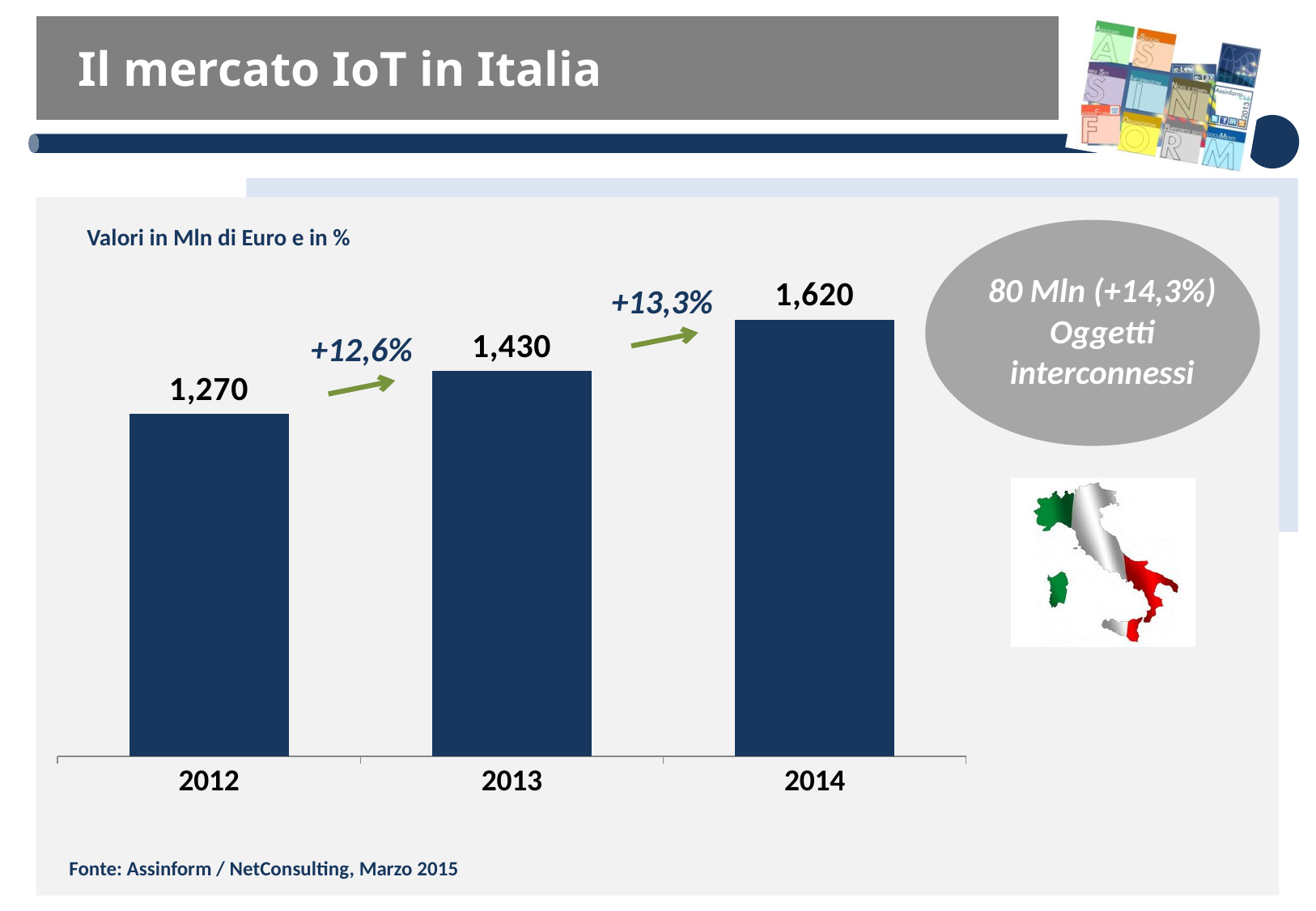
Which is larger, the value for 2013 or the value for 2014? 2014 Which year has the lowest value? 2012 What is the value for 2014? 1,620 What is the value for 2013? 1,430 What is the difference between the values for 2014 and 2012? 350 What is the difference between the values for 2013 and 2012? 160 What kind of chart is shown? bar chart Which year has the highest value? 2014 What percentage growth is shown between 2013 and 2014? +13,3% Do the values rise or fall from 2012 to 2014? rise What is the value for 2012? 1,270 How many years are shown on the x axis? 3